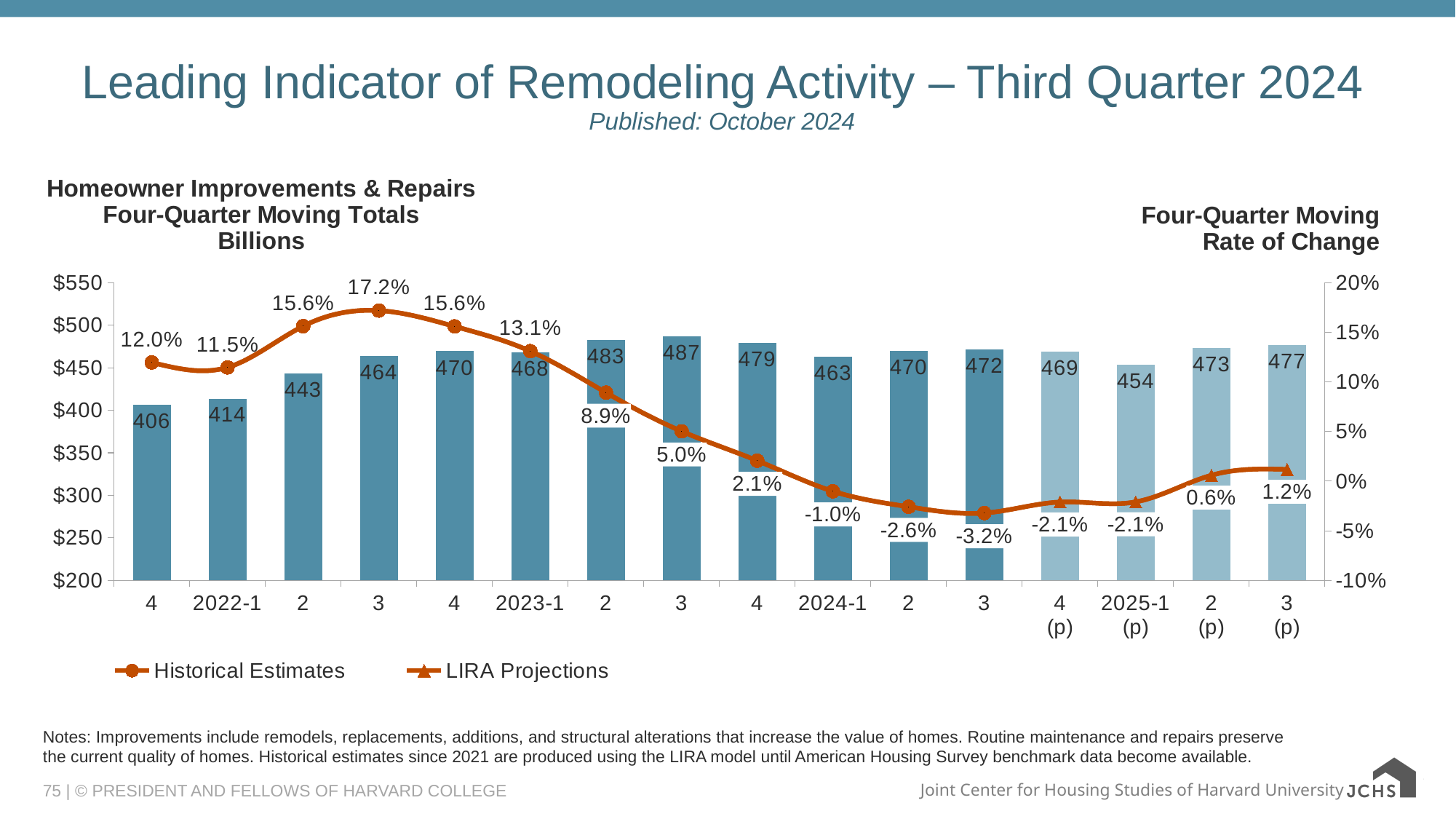
Which quarter has the lowest four-quarter moving rate of change? 2024-3 (-3.2%) What is the projected four-quarter moving total for 2025-1 (p)? 454 Is the four-quarter moving rate of change for 2023-2 greater or less than 10%? less What is the four-quarter moving rate of change for 2022-3? 17.2% Which is larger, the four-quarter moving total for 2024-2 or for 2025-3 (p)? 2025-3 (p), 477 How many quarters (bars) are shown on the chart? 16 How many series does the legend list? 2 Does the four-quarter moving rate of change rise or fall from 2022-3 to 2024-3? fall What kind of chart is shown on the slide? Combined bar and line chart What is the four-quarter moving total (in billions) for 2024-1? 463 What is the difference between the four-quarter moving totals for 2023-2 and 2022-1? 69 Which quarter has the highest four-quarter moving total bar? 2023-3 (487)